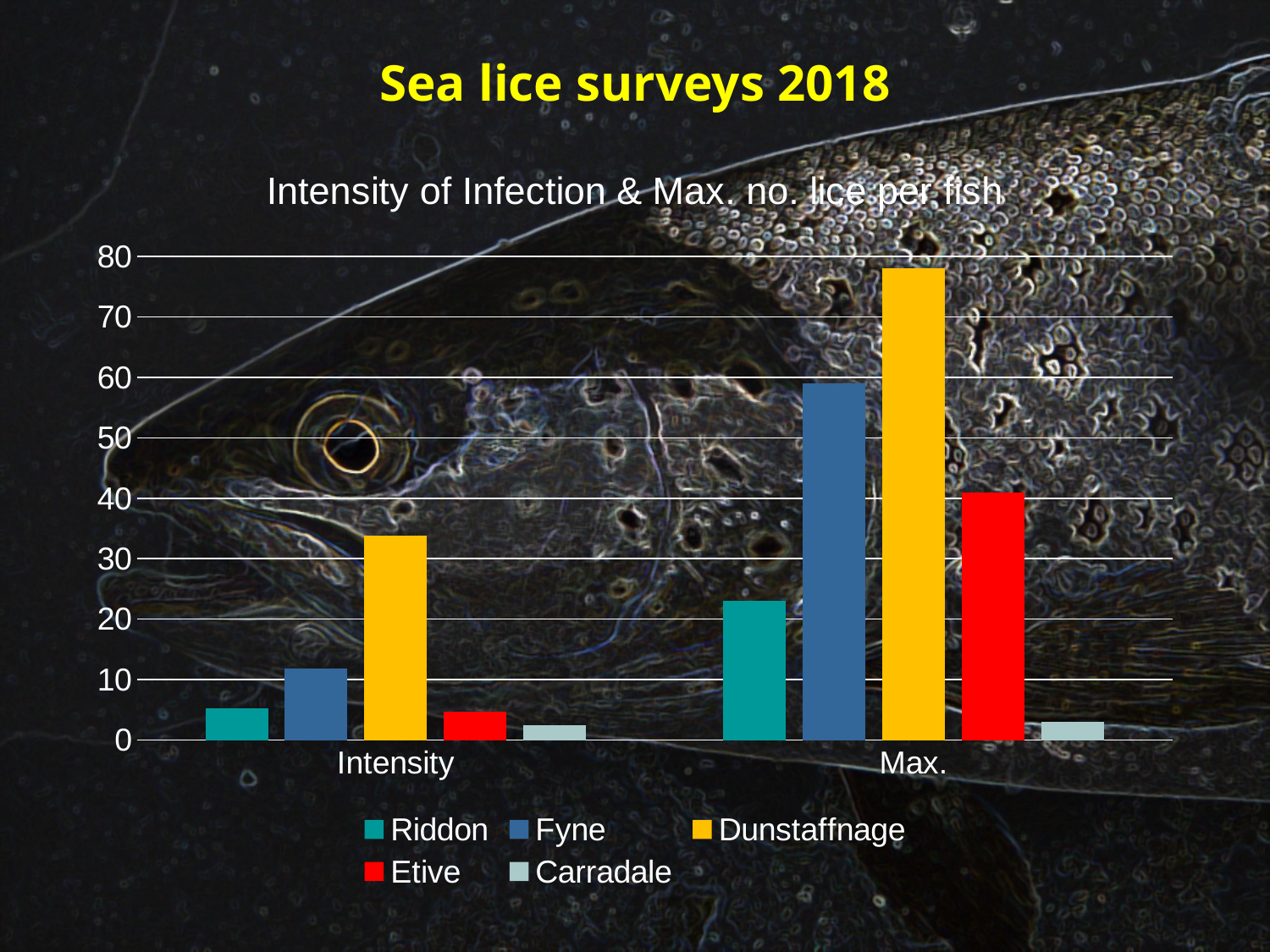
Is the value for Riddon in the Intensity category greater or less than 10? less How many series does the legend list? 5 What kind of chart is shown on the slide? bar chart Is the value for Fyne in the Max. category greater or less than 50? greater Which series has the lowest value in the Max. category? Carradale Which colour represents Etive in the legend? red What is the title of the chart? Intensity of Infection & Max. no. lice per fish Which series has the highest value in the Intensity category? Dunstaffnage Which is larger in the Max. category, Etive or Riddon? Etive Which series has the highest value in the Max. category? Dunstaffnage Is the value for Dunstaffnage in the Max. category greater or less than 70? greater How many categories are shown on the x axis? 2